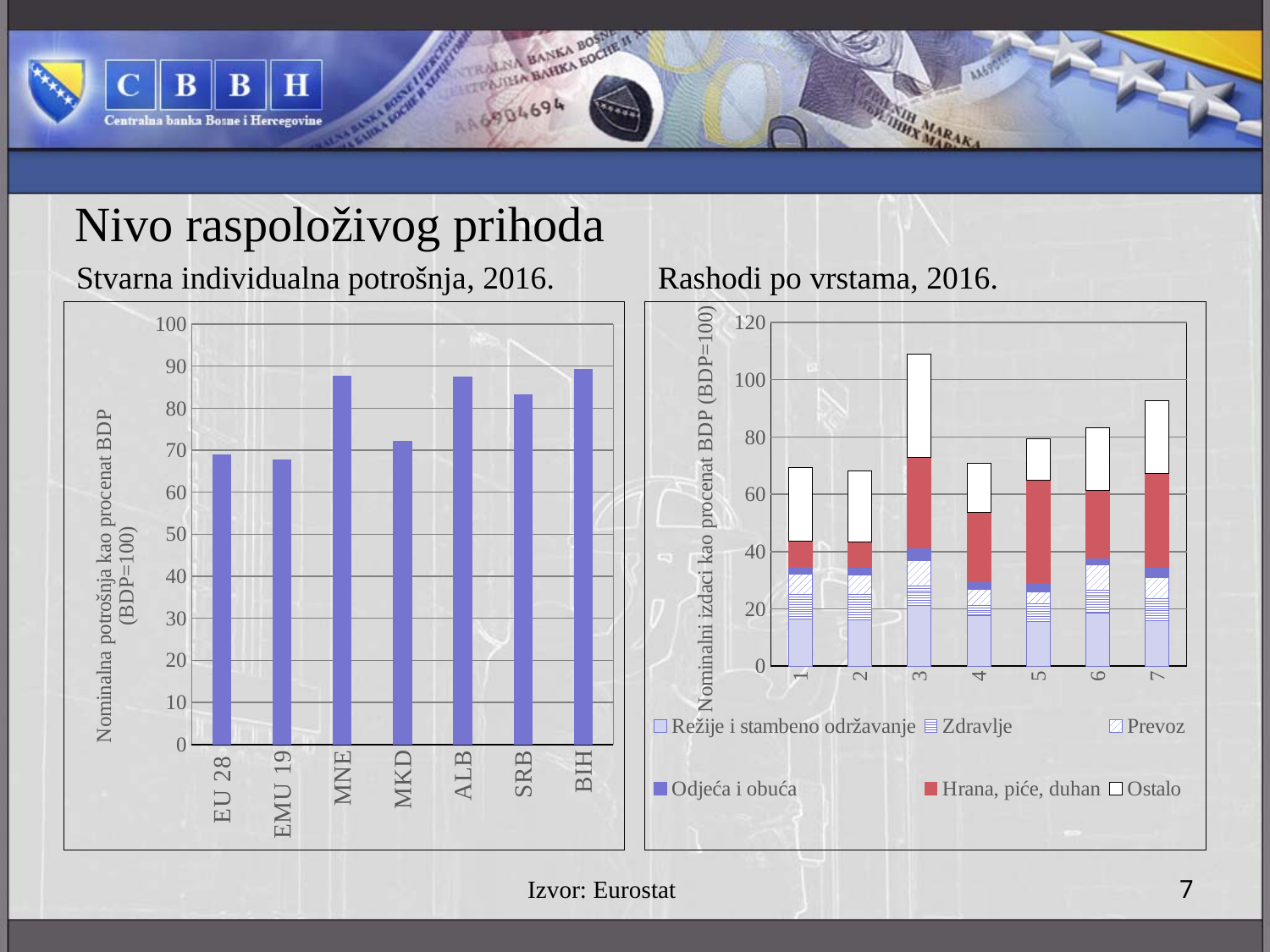
How many series does the legend of the right chart "Rashodi po vrstama, 2016." list? 6 In the right chart "Rashodi po vrstama, 2016.", which category has the tallest stacked bar? 3 In the left chart "Stvarna individualna potrošnja, 2016.", is the value for MKD greater or less than 80? less In the left chart "Stvarna individualna potrošnja, 2016.", which is larger, the value for ALB or the value for SRB? ALB In the right chart "Rashodi po vrstama, 2016.", which legend entry is shown in red? Hrana, piće, duhan In the left chart "Stvarna individualna potrošnja, 2016.", which is larger, the value for MNE or the value for MKD? MNE How many bars are shown in the right chart "Rashodi po vrstama, 2016."? 7 In the left chart "Stvarna individualna potrošnja, 2016.", is the value for EU 28 greater or less than 80? less What kind of chart is the left chart titled "Stvarna individualna potrošnja, 2016."? bar chart How many categories are shown on the x axis of the left chart "Stvarna individualna potrošnja, 2016."? 7 In the left chart "Stvarna individualna potrošnja, 2016.", is the value for BIH greater or less than 80? greater